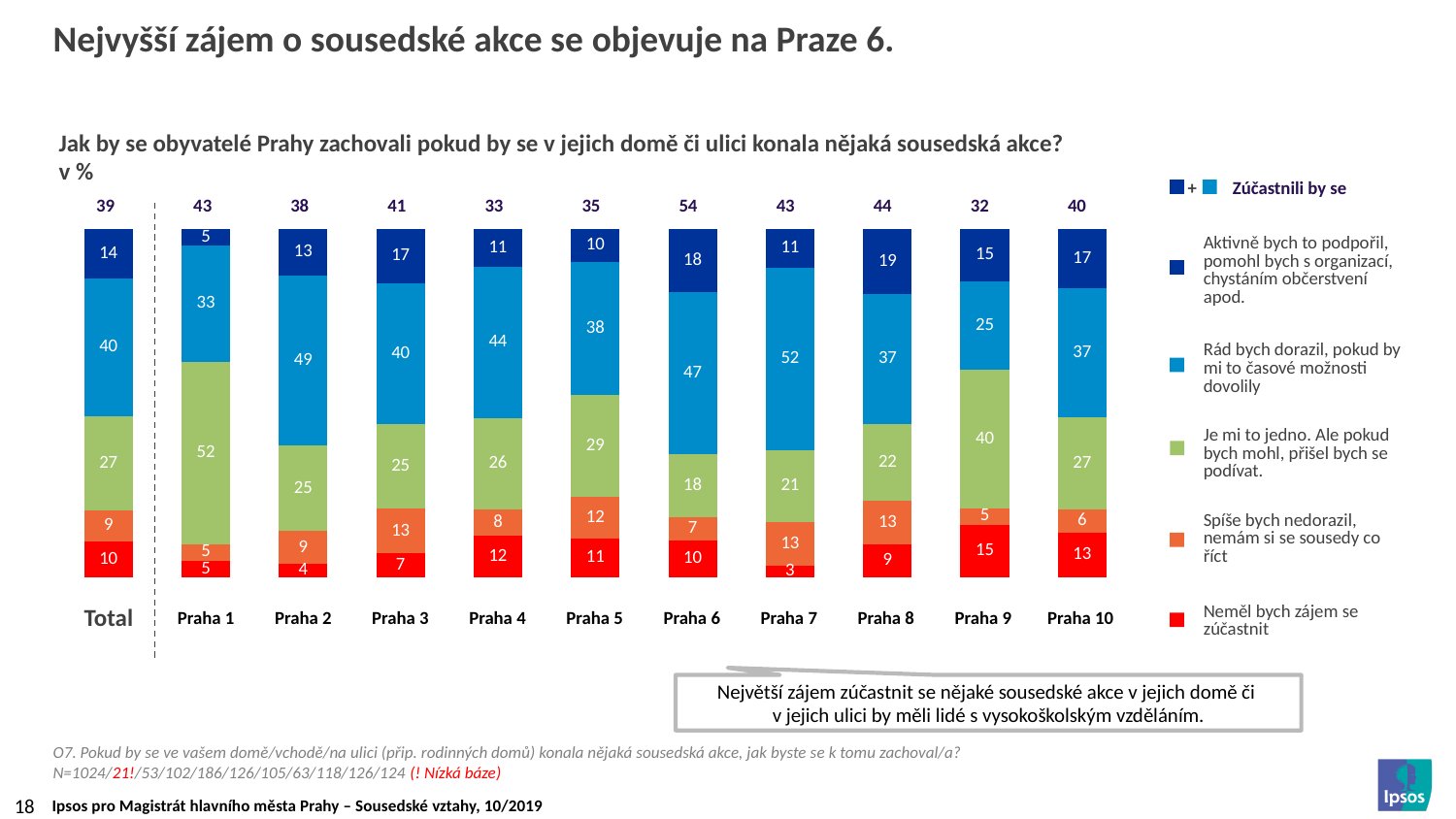
How many categories (bars) are shown on the x axis? 11 Which category has the highest "Zúčastnili by se" value shown above the bars? Praha 6 How many series does the legend list for the stacked bars? 5 What is the total of the stacked bar for Praha 1? 100 What is the difference between the "Zúčastnili by se" values for Praha 6 and Praha 9? 22 Which is larger in the series "Rád bych dorazil, pokud by mi to časové možnosti dovolily": Praha 2 or Praha 7? Praha 7 What is the value for Praha 9 in the series "Je mi to jedno. Ale pokud bych mohl, přišel bych se podívat."? 40 What is the value for Praha 6 in the series "Rád bych dorazil, pokud by mi to časové možnosti dovolily"? 47 Which legend entry is shown in dark blue? Aktivně bych to podpořil, pomohl bych s organizací, chystáním občerstvení apod. What is the value for Total in the series "Neměl bych zájem se zúčastnit"? 10 What kind of chart is shown on the slide? Stacked bar chart Which category has the lowest "Zúčastnili by se" value shown above the bars? Praha 9